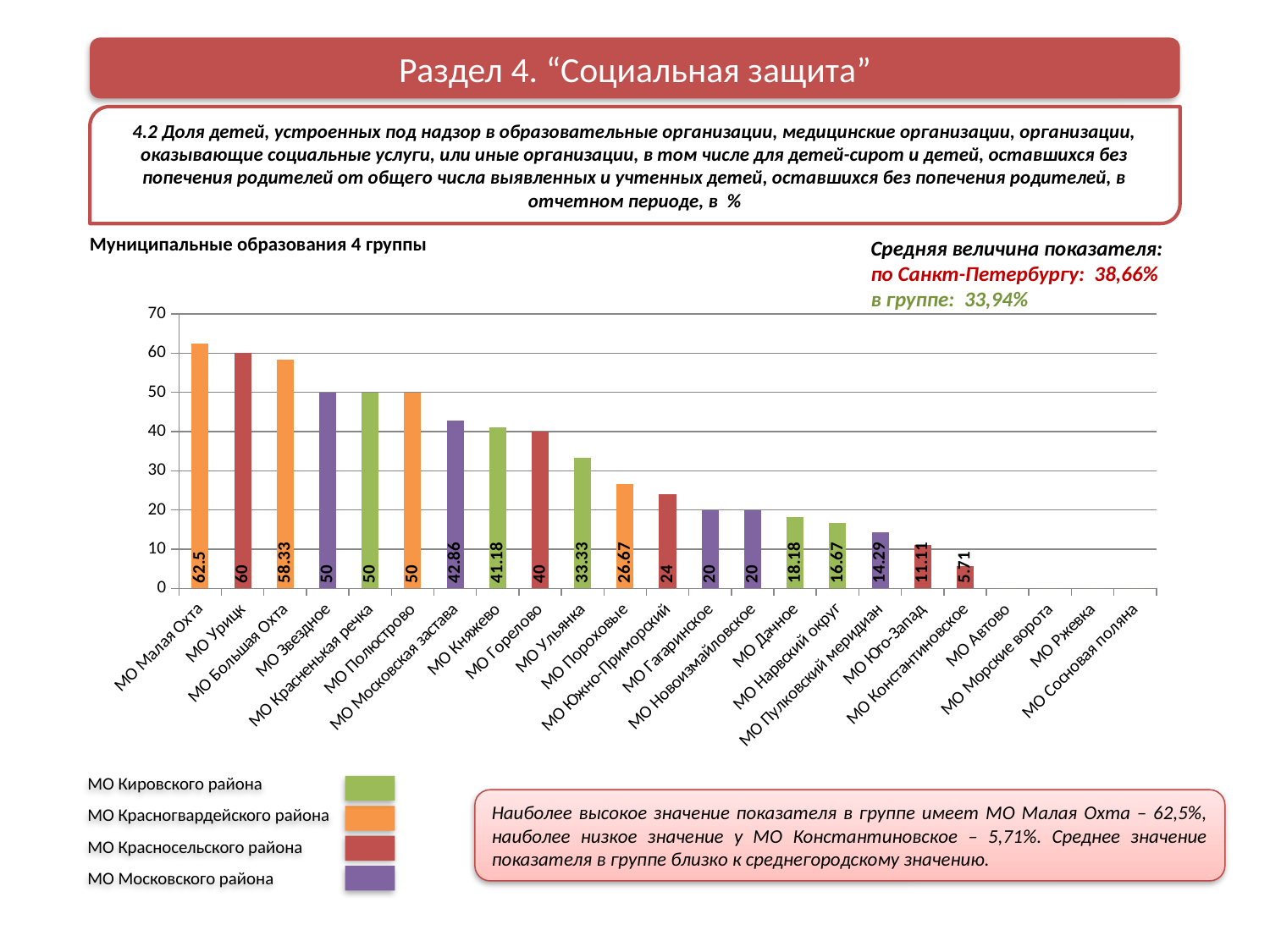
How many district groups does the legend list? 4 Which is larger, the value for МО Ульянка or the value for МО Горелово? МО Горелово What is the value for МО Пулковский меридиан? 14.29 What is the value for МО Малая Охта? 62.5 Do the bar values rise or fall from left to right along the x axis? fall Which municipality with a plotted bar has the lowest value? МО Константиновское What is the value for МО Московская застава? 42.86 Which municipality has the highest value on the chart? МО Малая Охта How many municipalities are listed on the x axis of the chart? 23 What is the difference between the values for МО Пороховые and МО Южно-Приморский? 2.67 What is the difference between the values for МО Малая Охта and МО Урицк? 2.5 What kind of chart is shown on the slide? bar chart